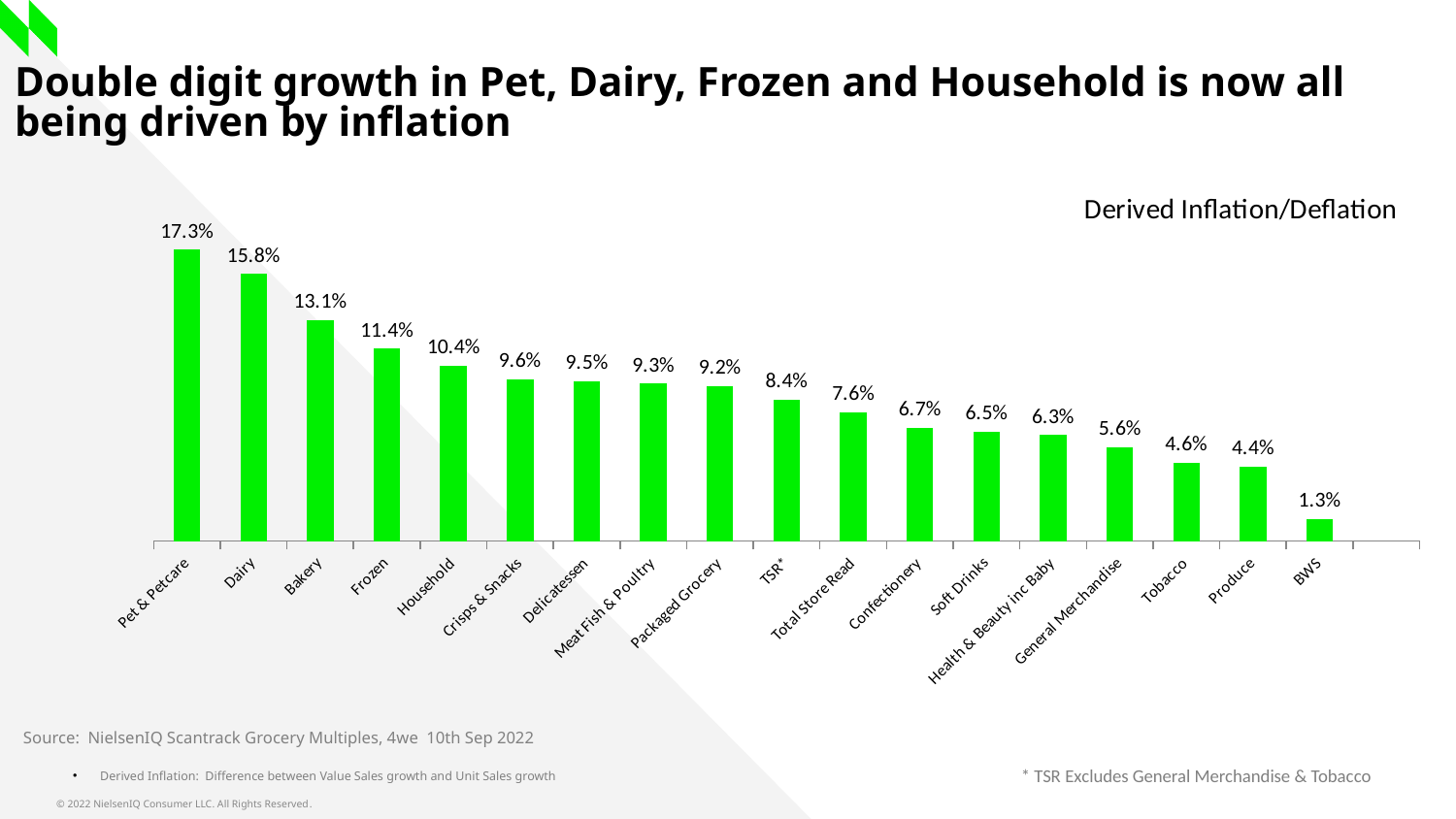
What type of chart is shown on the slide? Bar chart What is the derived inflation value for Tobacco? 4.6% What is the derived inflation value for Household? 10.4% What is the difference between the derived inflation for Frozen and BWS? 10.1% Which has a higher derived inflation, Confectionery or Produce? Confectionery How many categories are shown in the chart? 18 What is the derived inflation value for Pet & Petcare? 17.3% What is the difference between the derived inflation for Dairy and Bakery? 2.7% Which category has the lowest derived inflation? BWS Which category has the highest derived inflation? Pet & Petcare Do the values rise or fall moving from left to right along the x axis? Fall What is the derived inflation value for Total Store Read? 7.6%